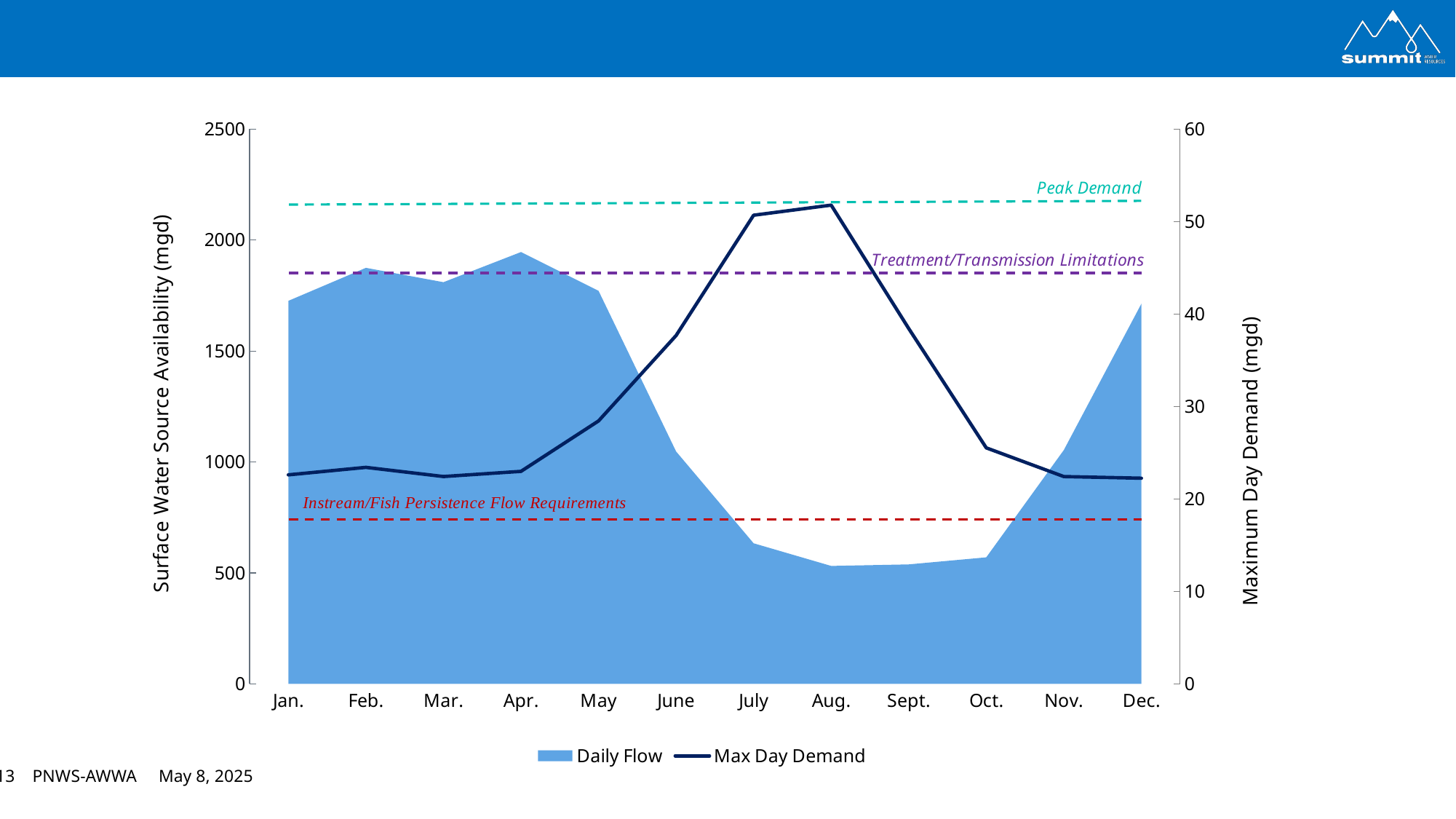
How many series does the chart's legend list? 2 Does the Max Day Demand line rise or fall from Apr. to Aug.? rise What kind of chart is shown on the slide? Combined area and line chart Is the Daily Flow value for Apr. greater or less than 1500? greater Is the Daily Flow value for Aug. greater or less than 1000? less How many months are shown on the x axis of the chart? 12 Is the Max Day Demand value for July greater or less than 40? greater What is the title of the right-hand vertical axis? Maximum Day Demand (mgd) Which is larger, the Daily Flow in Apr. or the Daily Flow in Aug.? Apr. What does the red dashed line on the chart represent? Instream/Fish Persistence Flow Requirements In which month is the Daily Flow highest? Apr.